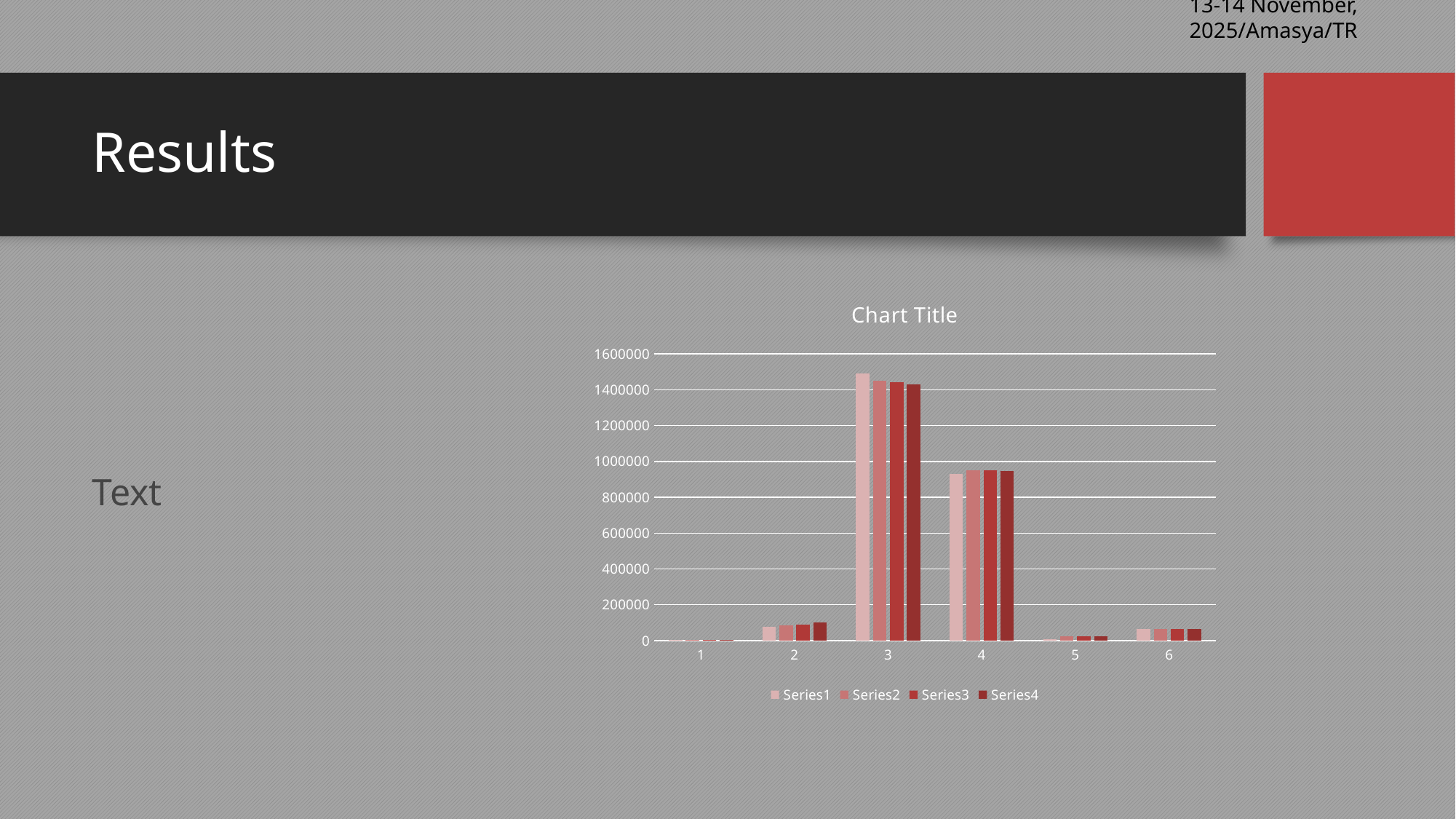
Is the value for Series4 in category 4 greater or less than 800000? greater Which category has the lowest values in the chart? 1 For Series3, which category has the larger value, 2 or 5? 2 Is the value for Series1 in category 3 greater or less than 1400000? greater For Series2, which category has the larger value, 3 or 4? 3 Is the value for Series1 in category 4 greater or less than 1000000? less What kind of chart is shown on the slide? bar chart How many series does the chart's legend list? 4 How many categories are shown on the x axis of the chart? 6 Which category has the highest values in the chart? 3 What is the title of the chart? Chart Title